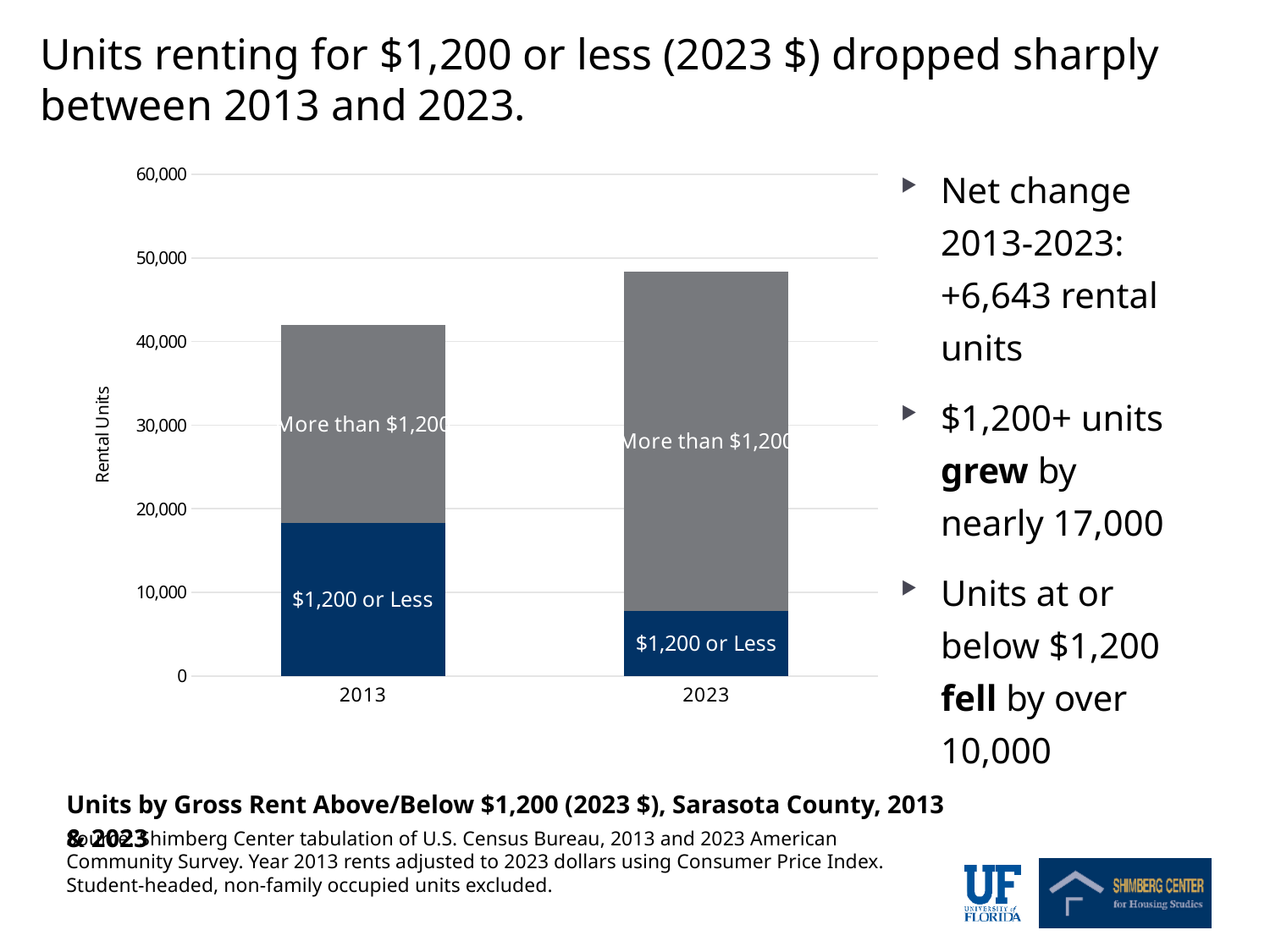
How many years (categories) are shown on the x axis of the chart? 2 Does the "$1,200 or Less" segment rise or fall from 2013 to 2023? fall Which year has the larger "More than $1,200" segment, 2013 or 2023? 2023 Which year has the larger total number of rental units, 2013 or 2023? 2023 Which year has the larger "$1,200 or Less" segment, 2013 or 2023? 2013 How many rent segments are stacked in each bar of the chart? 2 What kind of chart is shown on the slide? Stacked bar chart Is the total height of the 2023 bar greater or less than 50,000? less Is the total height of the 2013 bar greater or less than 40,000? greater Is the value of the "$1,200 or Less" segment for 2013 greater or less than 20,000? less What is the label on the vertical axis of the chart? Rental Units